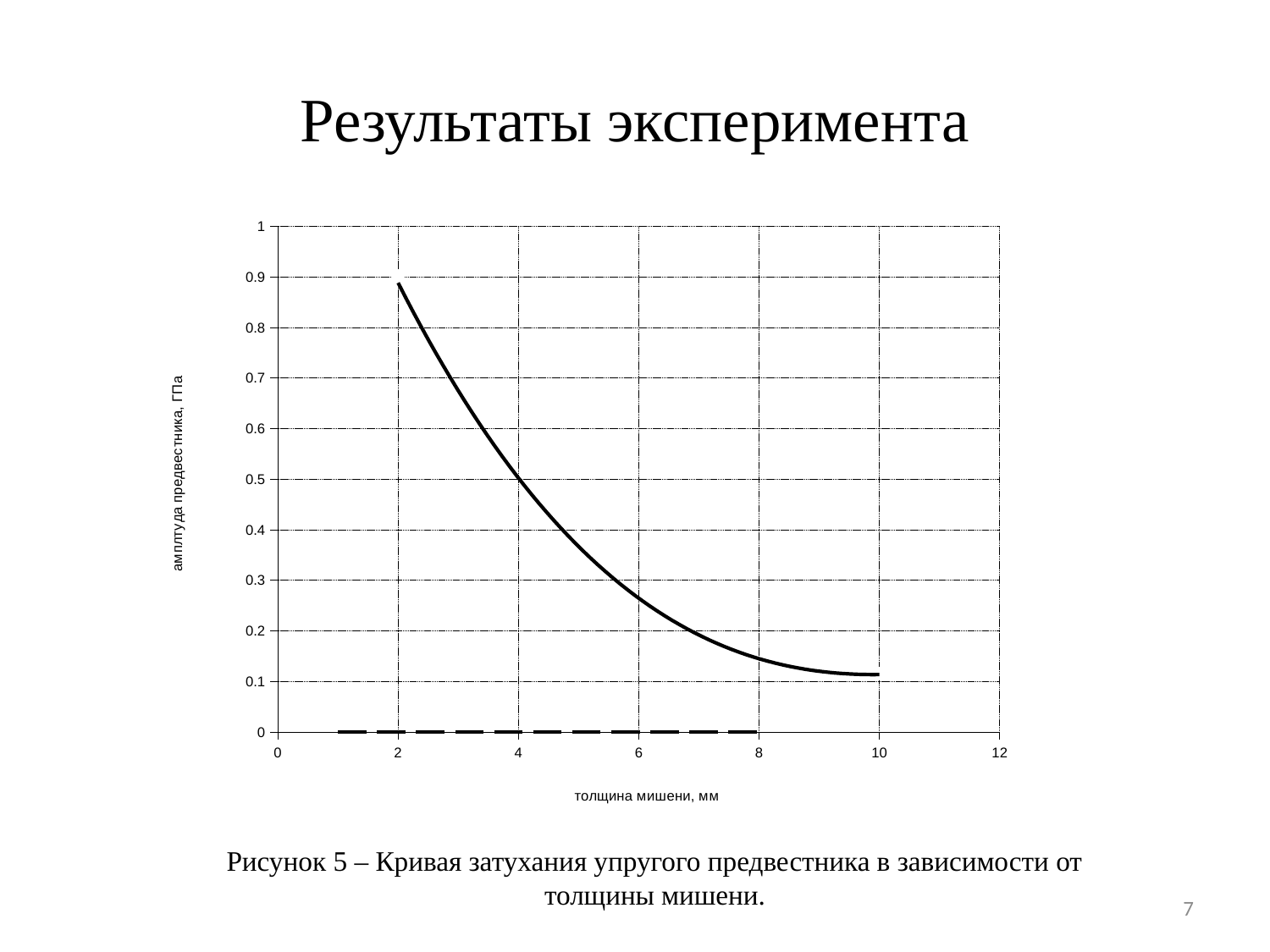
What is the label of the y axis? амплтуда предвестника, ГПа What is the highest tick value shown on the x axis? 12 Is the amplitude at a target thickness of 10 mm greater or less than 0.2 GPa? less Is the amplitude at a target thickness of 8 mm greater or less than 0.2 GPa? less Which is larger: the amplitude at a thickness of 2 mm or at a thickness of 10 mm? 2 mm Does the amplitude of the precursor rise or fall as the target thickness increases along the x axis? fall Is the amplitude at a target thickness of 2 mm greater or less than 0.8 GPa? greater What is the label of the x axis? толщина мишени, мм At which target thickness shown on the curve is the amplitude highest? 2 mm What kind of chart is shown on the slide? line chart